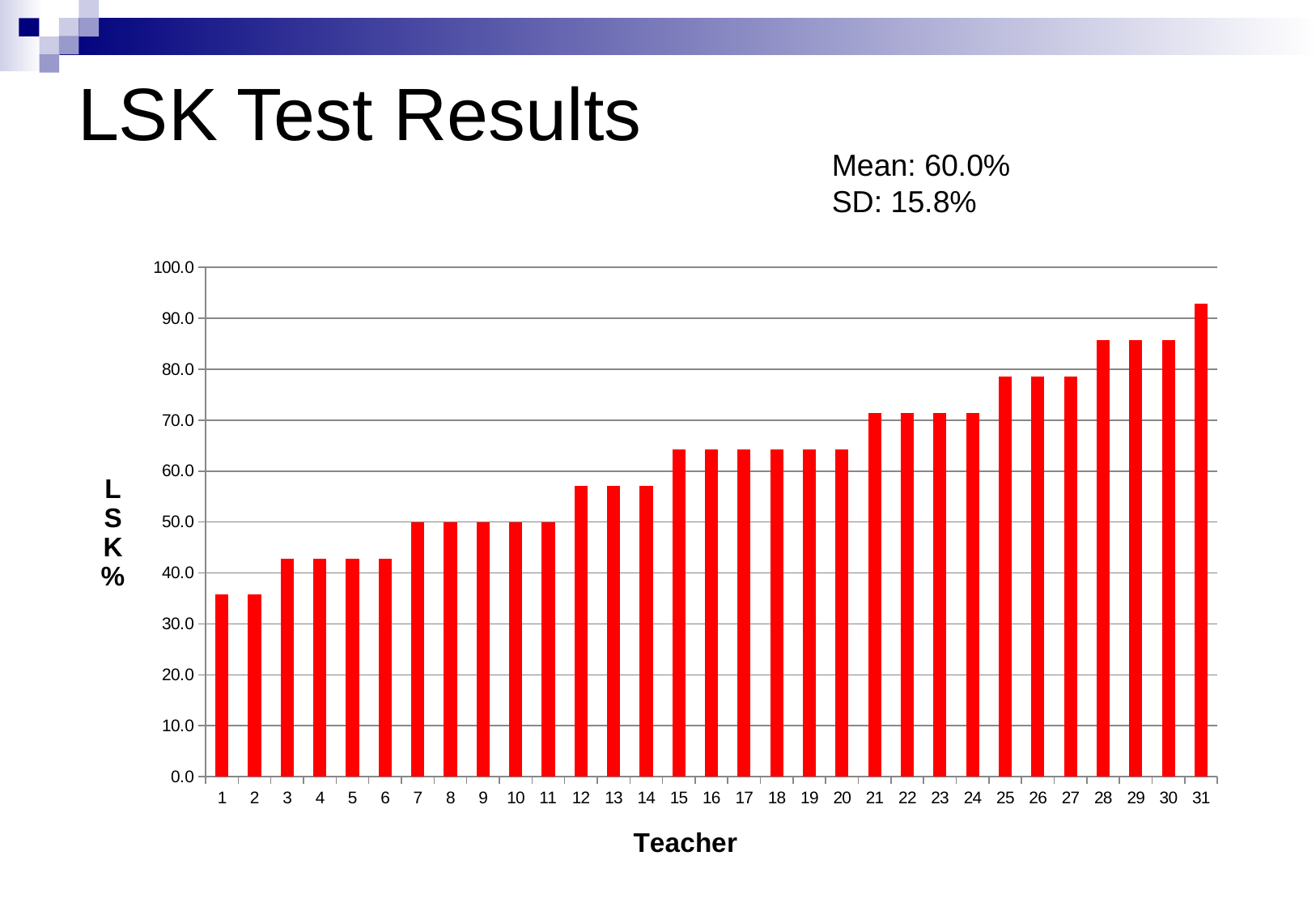
What is the LSK % value for Teacher 10? 50.0 What is the title of the x axis of the chart? Teacher Is the value for Teacher 15 greater or less than 60.0? greater What is the LSK % value for Teacher 7? 50.0 Is the value for Teacher 1 greater or less than 40.0? less How many teachers are plotted on the x axis of the chart? 31 Do the LSK % values rise or fall as you move from Teacher 1 to Teacher 31 along the x axis? rise What kind of chart is shown on the slide? bar chart Which has the larger LSK % value, Teacher 20 or Teacher 21? Teacher 21 Is the value for Teacher 31 greater or less than 90.0? greater Which teacher has the highest LSK % value? Teacher 31